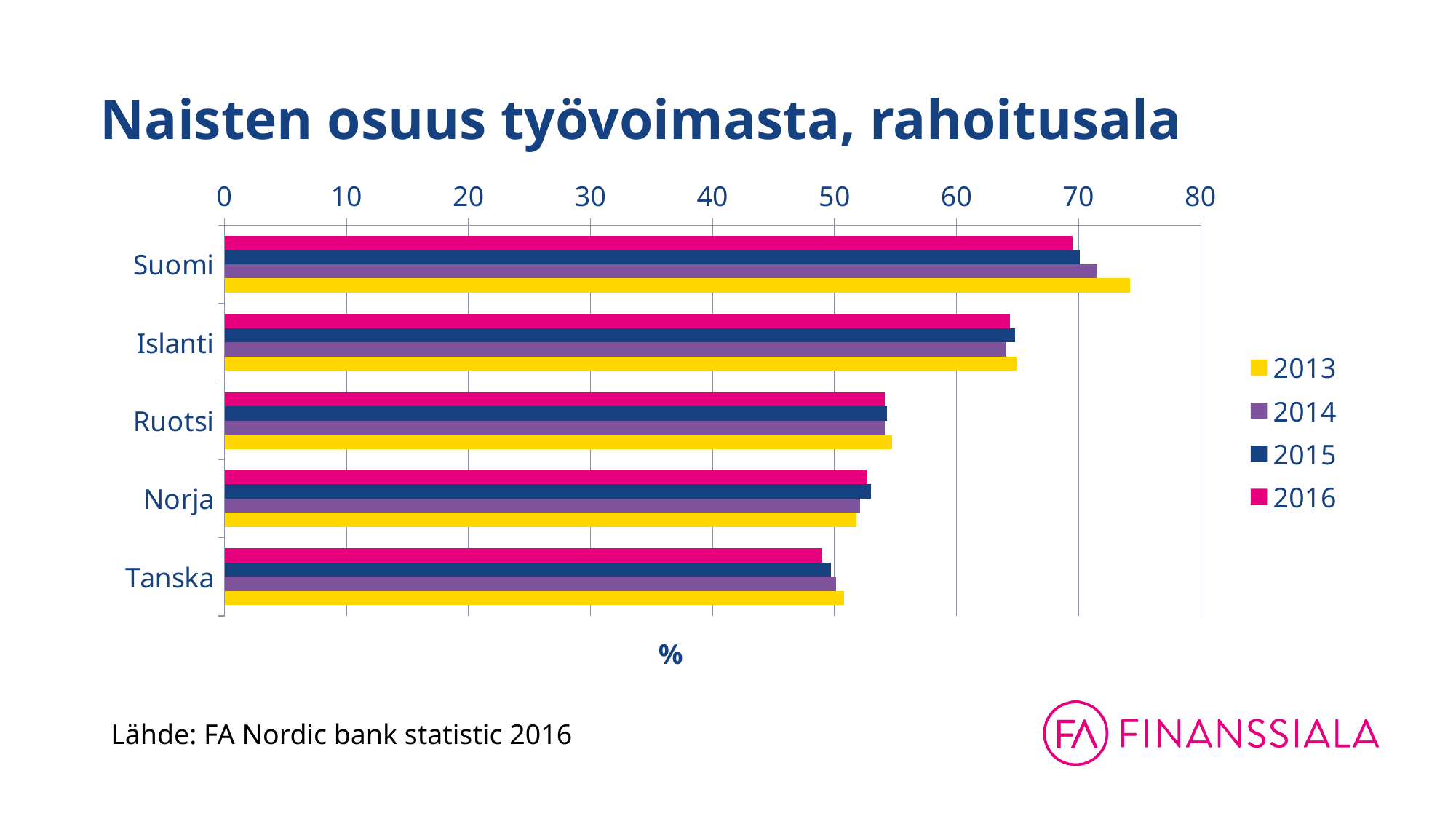
Is the value for Islanti in 2016 greater or less than 60? greater Is the value for Ruotsi in 2013 greater or less than 60? less What is the title of the chart? Naisten osuus työvoimasta, rahoitusala Do the values for Suomi rise or fall from 2013 to 2016? fall Is the value for Suomi in 2013 greater or less than 70? greater What kind of chart is shown on the slide? bar chart Which is larger, the 2016 value for Suomi or the 2016 value for Tanska? Suomi Which country has the highest value for 2013? Suomi How many countries are shown on the chart? 5 How many series does the legend list? 4 Which country has the lowest value for 2016? Tanska